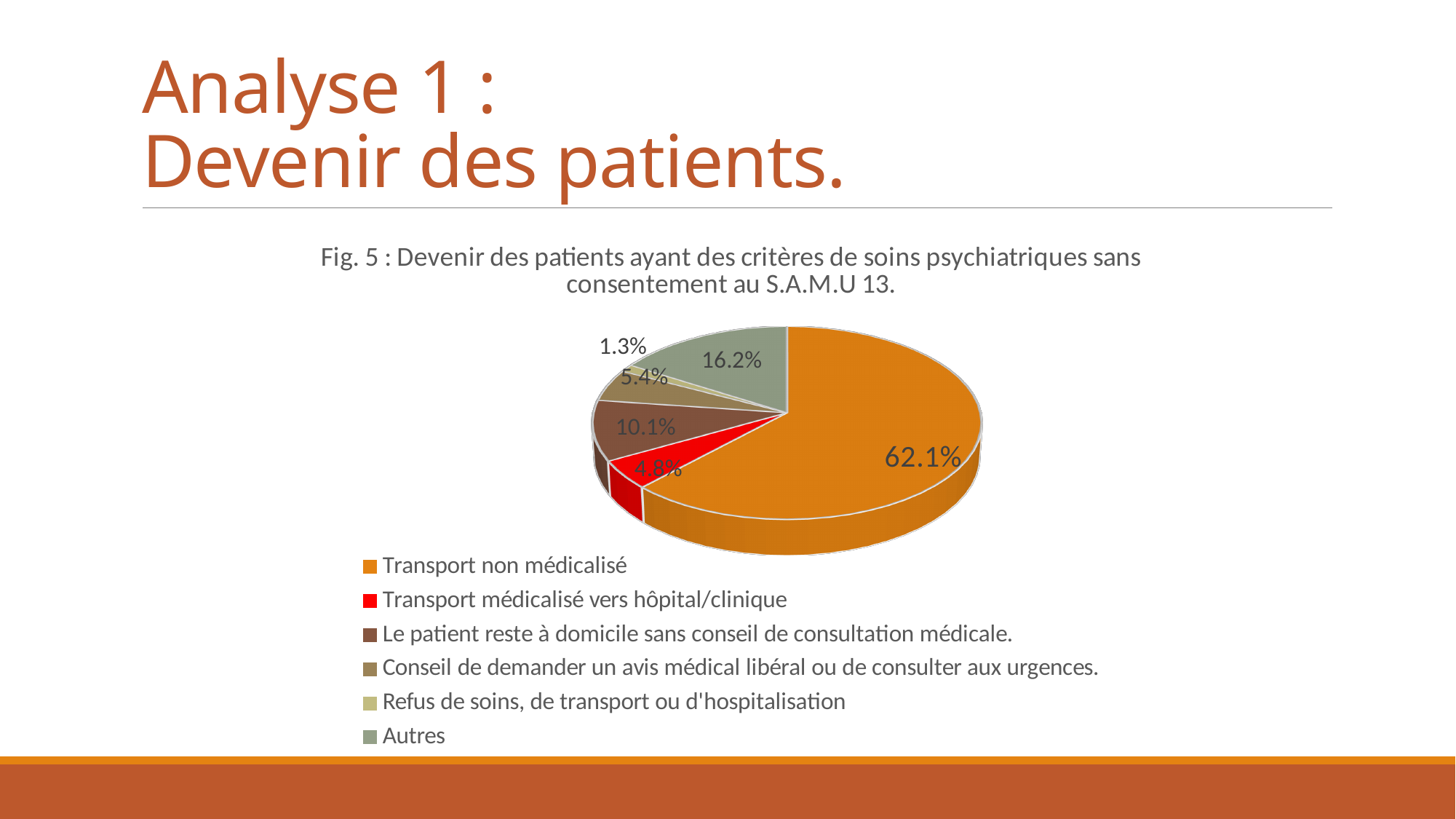
Which category has the smallest slice of the pie? Refus de soins, de transport ou d'hospitalisation What colour is the slice for 'Transport médicalisé vers hôpital/clinique'? Red What type of chart is shown on the slide? Pie chart What is the difference between the shares for 'Transport non médicalisé' and 'Autres'? 45.9% What percentage is shown for 'Transport médicalisé vers hôpital/clinique'? 4.8% What is the value for 'Refus de soins, de transport ou d'hospitalisation'? 1.3% What percentage is shown for 'Autres'? 16.2% What share of the pie does 'Transport non médicalisé' represent? 62.1% What is the value for 'Le patient reste à domicile sans conseil de consultation médicale.'? 10.1% Which category has the largest slice of the pie? Transport non médicalisé Which is larger: the share for 'Conseil de demander un avis médical libéral ou de consulter aux urgences.' or for 'Transport médicalisé vers hôpital/clinique'? Conseil de demander un avis médical libéral ou de consulter aux urgences. How many categories does the pie chart contain? 6